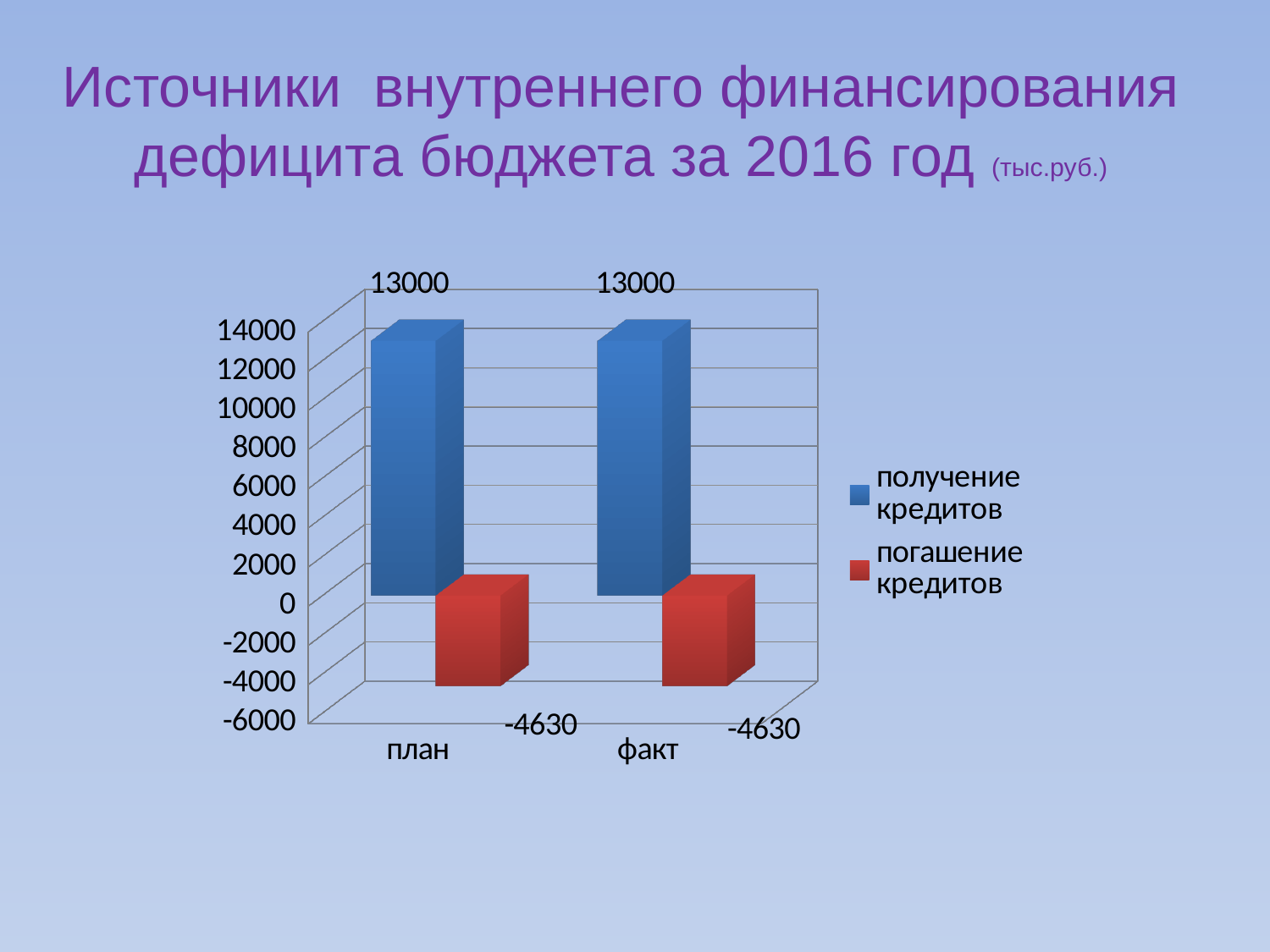
What is the value of погашение кредитов for факт? -4630 Which is larger for факт: получение кредитов or погашение кредитов? получение кредитов What is the difference between получение кредитов and погашение кредитов for план? 17630 How many categories are shown on the x axis? 2 How many series does the legend list? 2 What is the value of получение кредитов for факт? 13000 What kind of chart is shown on the slide? bar chart Is the value of получение кредитов for план greater or less than 12000? greater What is the value of получение кредитов for план? 13000 What is the value of погашение кредитов for план? -4630 What colour represents погашение кредитов in the legend? red Does the value of получение кредитов change from план to факт? No, it stays at 13000